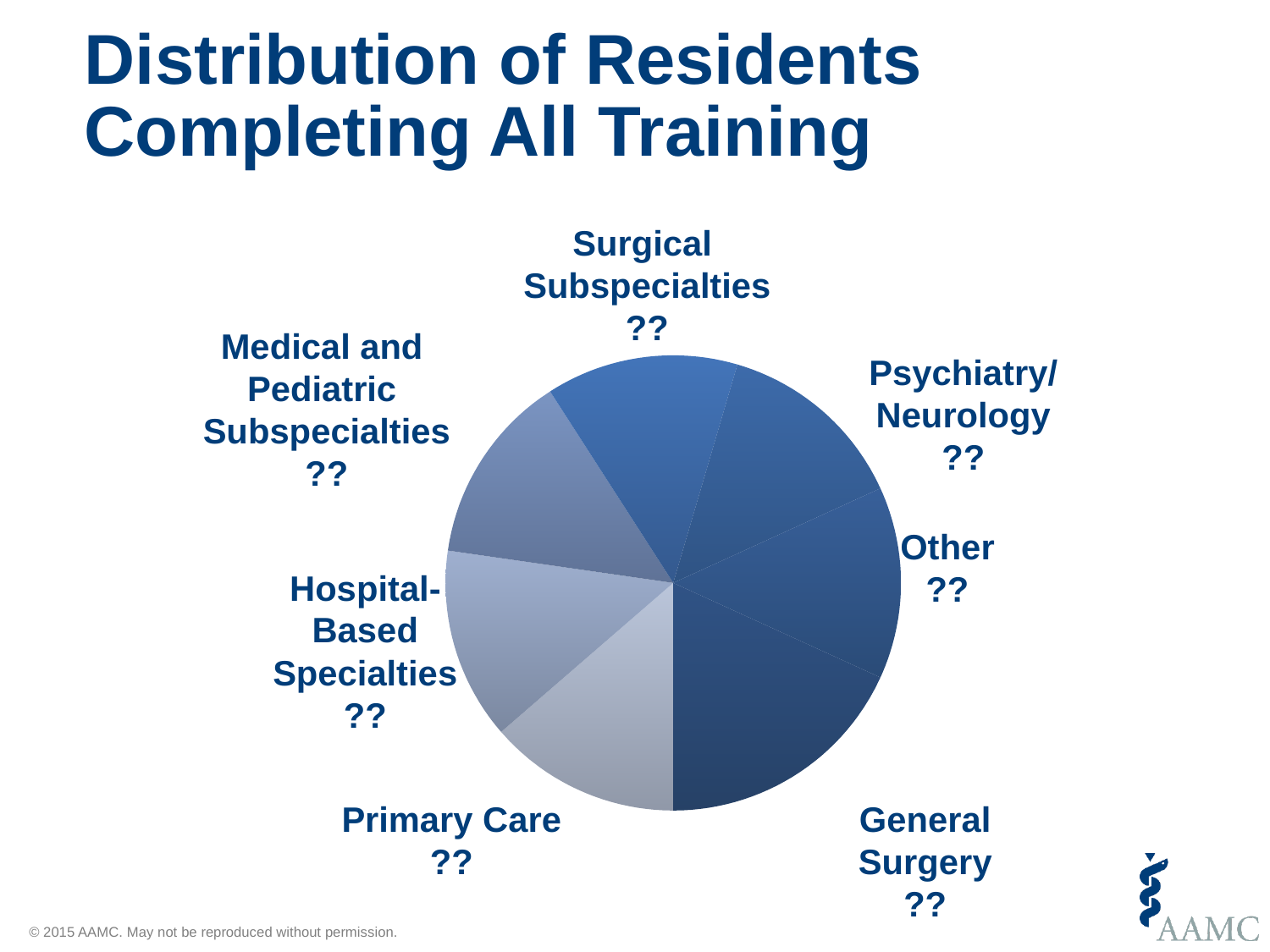
Which slice is larger, General Surgery or Primary Care? General Surgery What kind of chart is shown on the slide? Pie chart What is the title of the slide's chart? Distribution of Residents Completing All Training Which category has the largest slice of the pie chart? General Surgery What is shown in place of the value for each slice of the pie chart? ?? How many categories (slices) does the pie chart have? 7 Which slice is larger, General Surgery or Hospital-Based Specialties? General Surgery